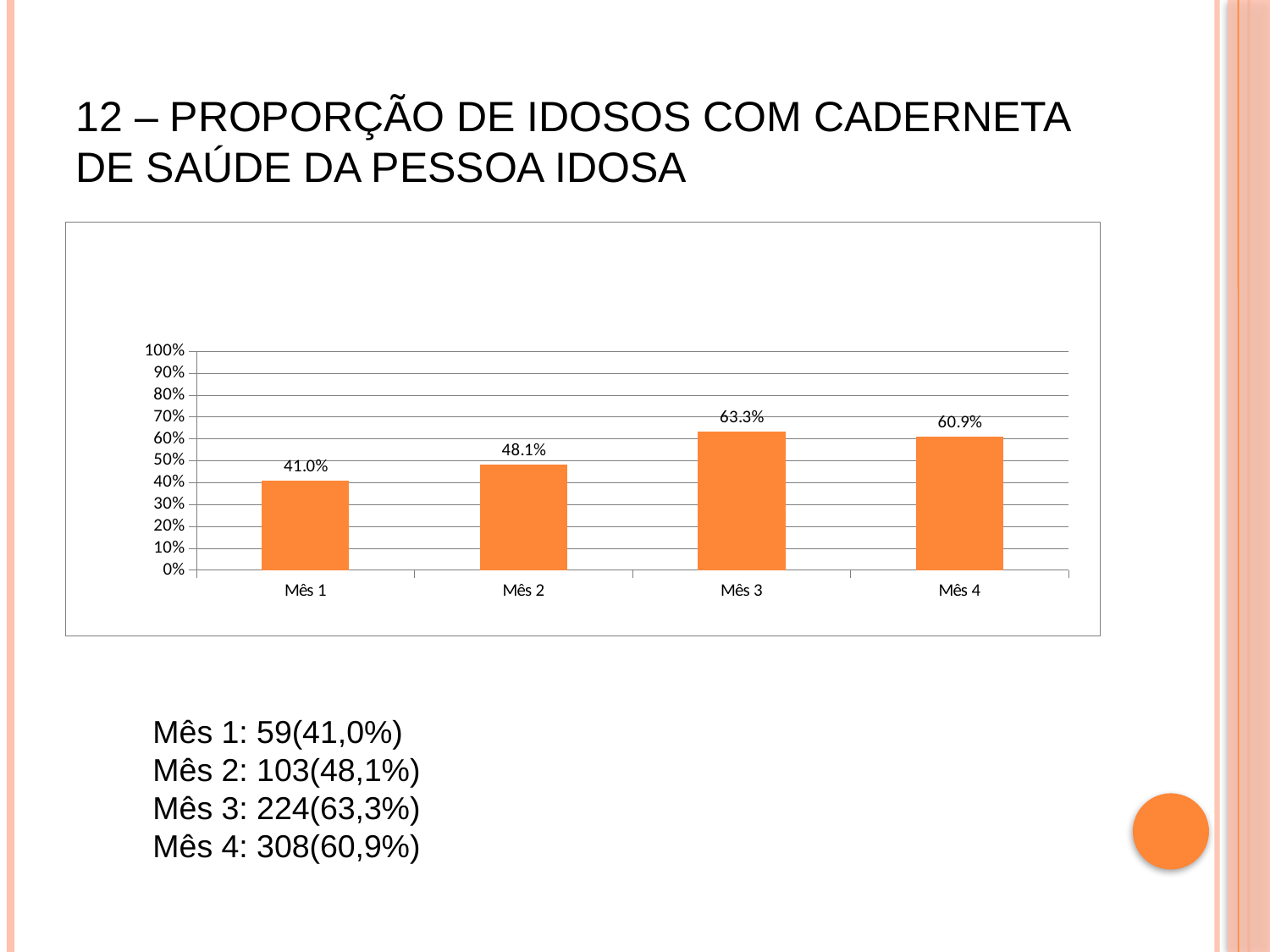
Is the value for Mês 2 greater or less than 50%? less What kind of chart is shown on the slide? bar chart Which month has the lowest value? Mês 1 What is the value for Mês 1? 41.0% Which is larger, the value for Mês 2 or the value for Mês 4? Mês 4 What colour are the bars in the chart? orange What is the value for Mês 4? 60.9% Which month has the highest value? Mês 3 How many months are shown on the x axis? 4 What is the value for Mês 2? 48.1% What is the value for Mês 3? 63.3% What is the difference between the values for Mês 3 and Mês 1? 22.3%